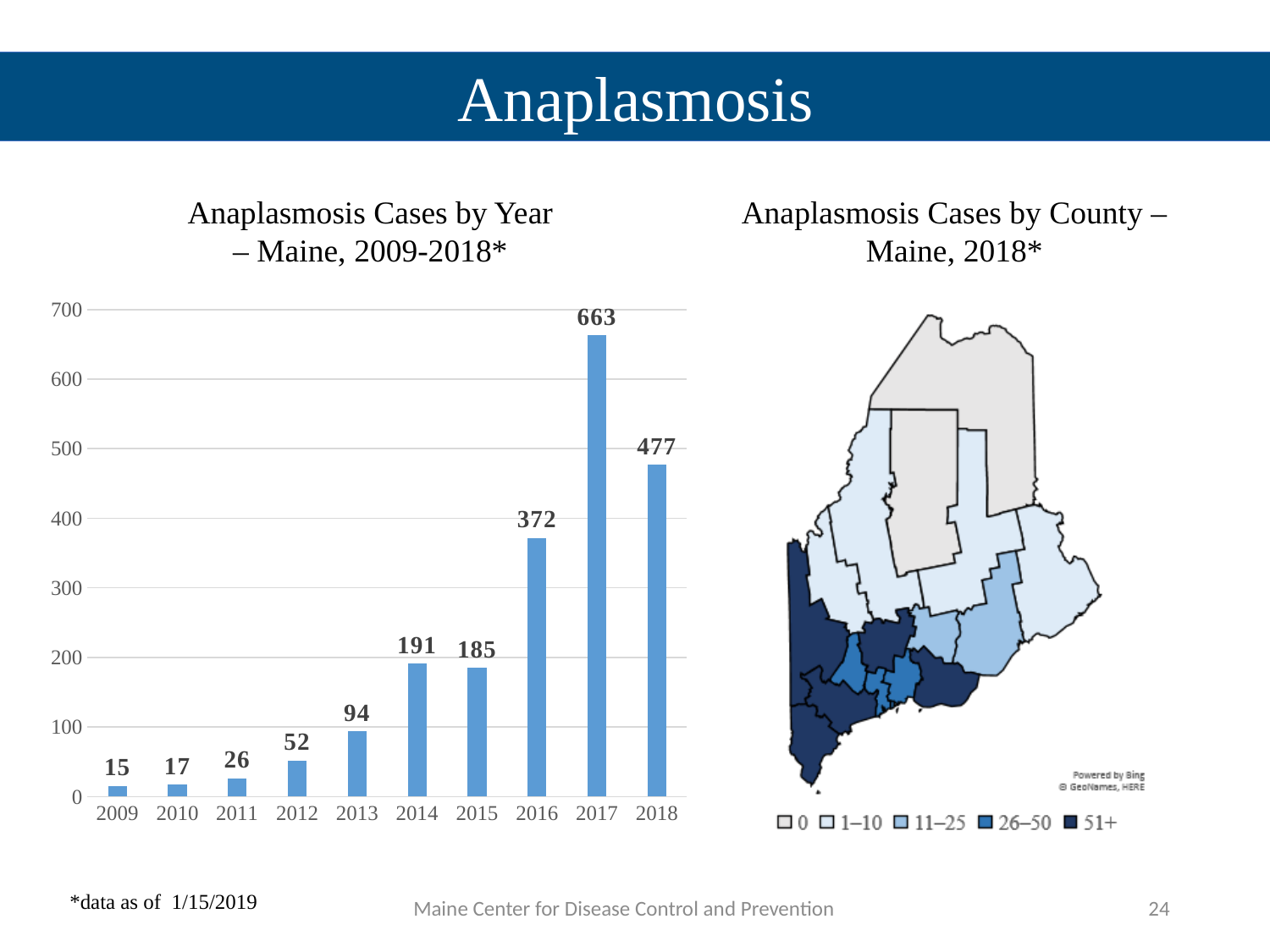
In the 'Anaplasmosis Cases by Year – Maine, 2009-2018*' chart, what is the difference in cases between 2012 and 2011? 26 In the 'Anaplasmosis Cases by Year – Maine, 2009-2018*' chart, which year has the lowest number of cases? 2009 In the 'Anaplasmosis Cases by Year – Maine, 2009-2018*' chart, how many cases were reported in 2013? 94 In the 'Anaplasmosis Cases by Year – Maine, 2009-2018*' chart, how many years are shown on the x axis? 10 In the 'Anaplasmosis Cases by Year – Maine, 2009-2018*' chart, how many cases were reported in 2017? 663 In the 'Anaplasmosis Cases by Year – Maine, 2009-2018*' chart, which year has the highest number of cases? 2017 In the 'Anaplasmosis Cases by Year – Maine, 2009-2018*' chart, which year had more cases, 2014 or 2015? 2014 In the 'Anaplasmosis Cases by Year – Maine, 2009-2018*' chart, what is the difference in cases between 2017 and 2018? 186 In the 'Anaplasmosis Cases by Year – Maine, 2009-2018*' chart, did cases rise or fall from 2009 to 2017? rise In the 'Anaplasmosis Cases by County – Maine, 2018*' map, how many categories does the legend list? 5 In the 'Anaplasmosis Cases by Year – Maine, 2009-2018*' chart, is the value for 2016 greater or less than 300? greater What kind of chart is the 'Anaplasmosis Cases by Year – Maine, 2009-2018*' chart? bar chart